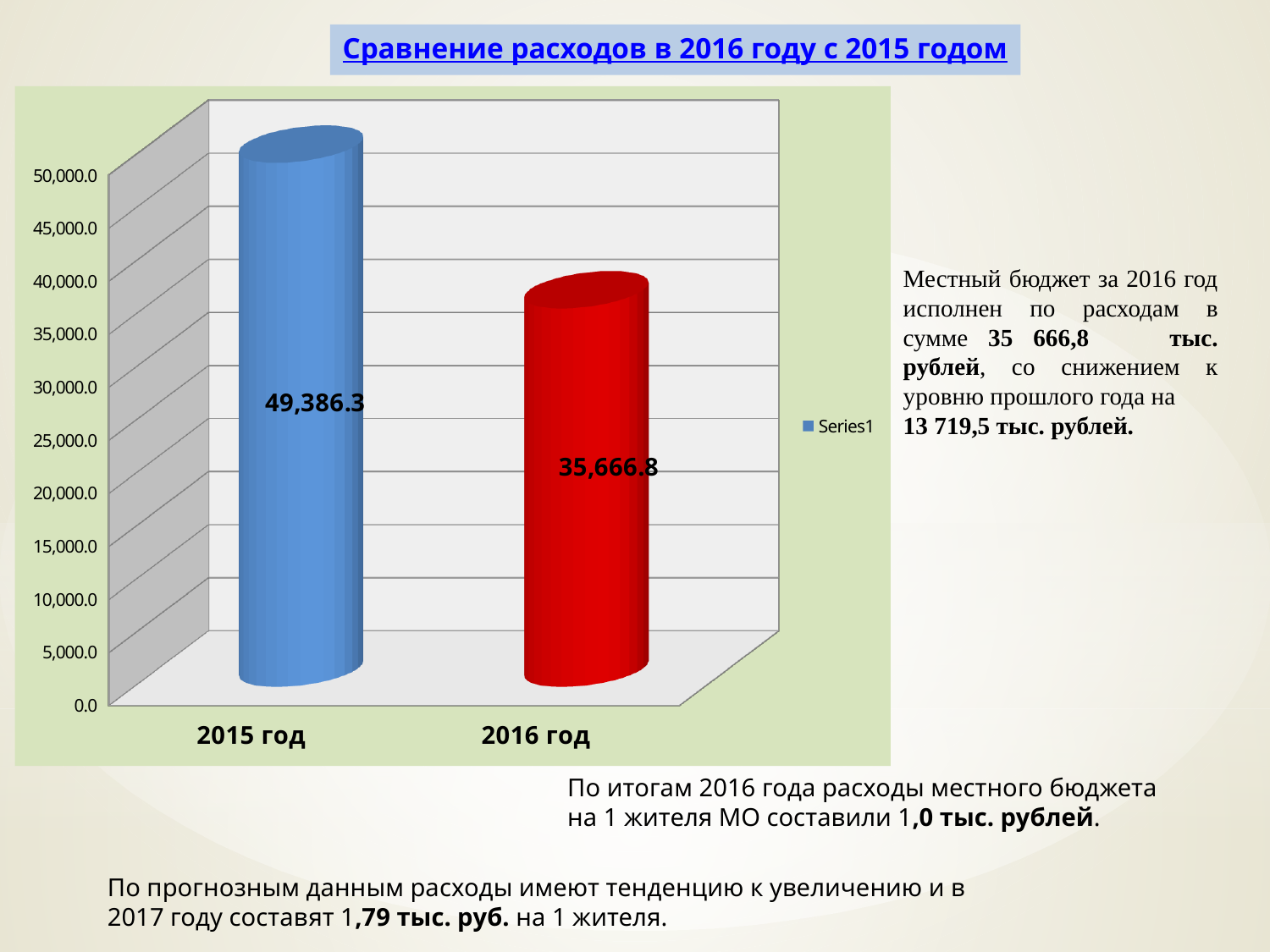
Do the values rise or fall from 2015 год to 2016 год? fall What is the difference between the values for 2015 год and 2016 год? 13,719.5 Is the value for 2016 год greater or less than 40,000.0? less How many series does the legend list? 1 What is the value shown for 2015 год? 49,386.3 What is the value shown for 2016 год? 35,666.8 Is the value for 2015 год greater or less than 45,000.0? greater Which year has the higher value on the chart? 2015 год What kind of chart is shown on the slide? bar chart Is the value for 2016 год larger or smaller than the value for 2015 год? smaller Which year has the lower value on the chart? 2016 год How many categories are plotted on the chart? 2